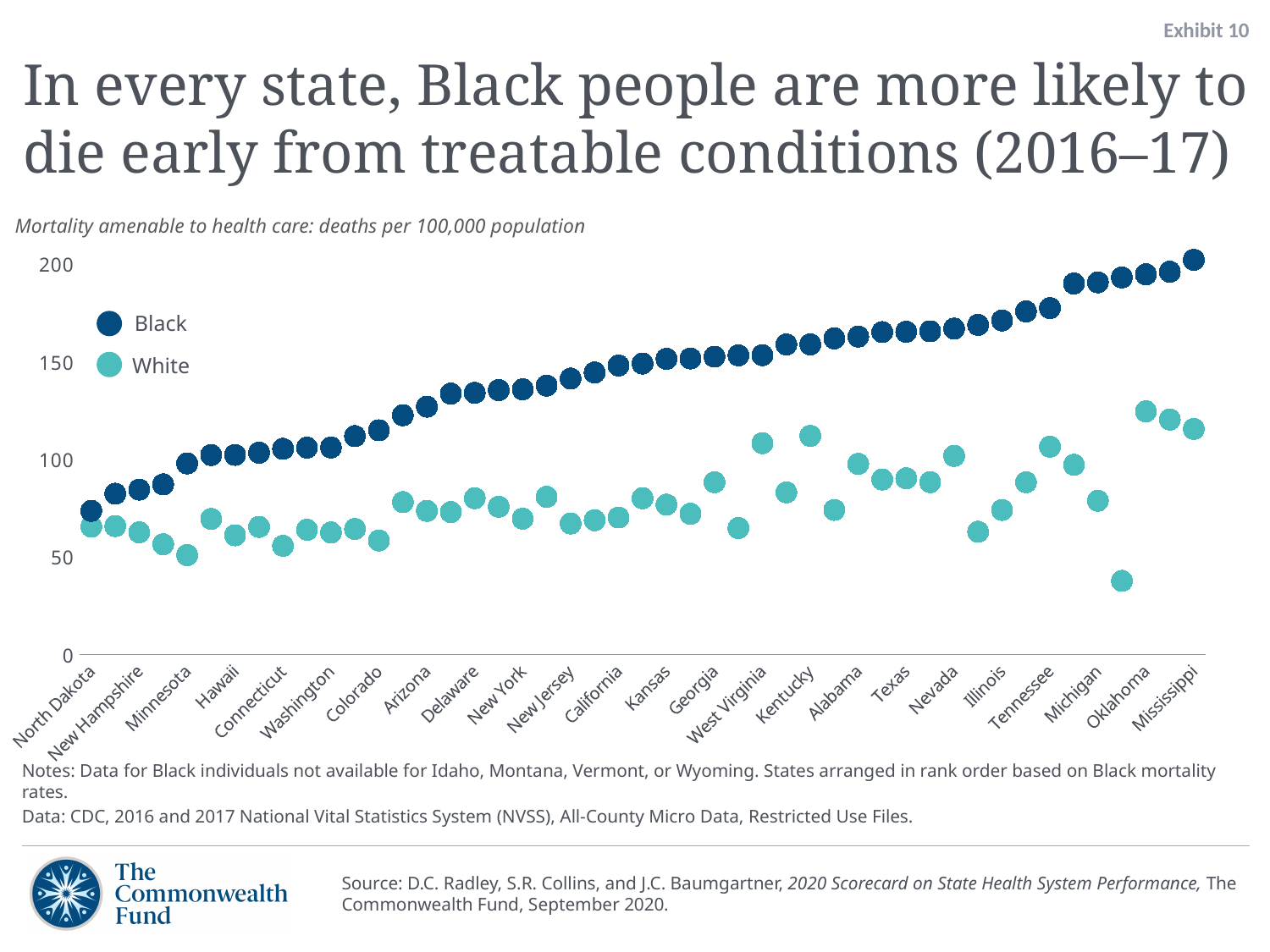
Is the White mortality value for Michigan greater or less than 100? less Which two series are shown in the legend? Black and White How many series does the legend list? 2 Is the Black mortality value for Arizona greater or less than 100? greater Is the Black mortality value for North Dakota greater or less than 100? less What kind of chart is shown on the slide? Scatter (dot) chart Which labeled state has the lowest Black mortality rate? North Dakota Which labeled state has the highest Black mortality rate? Mississippi For Mississippi, which is larger: the Black or the White mortality value? Black What does the y axis measure, according to the subtitle? Mortality amenable to health care: deaths per 100,000 population Do the Black mortality values rise or fall moving from left to right along the x axis? Rise